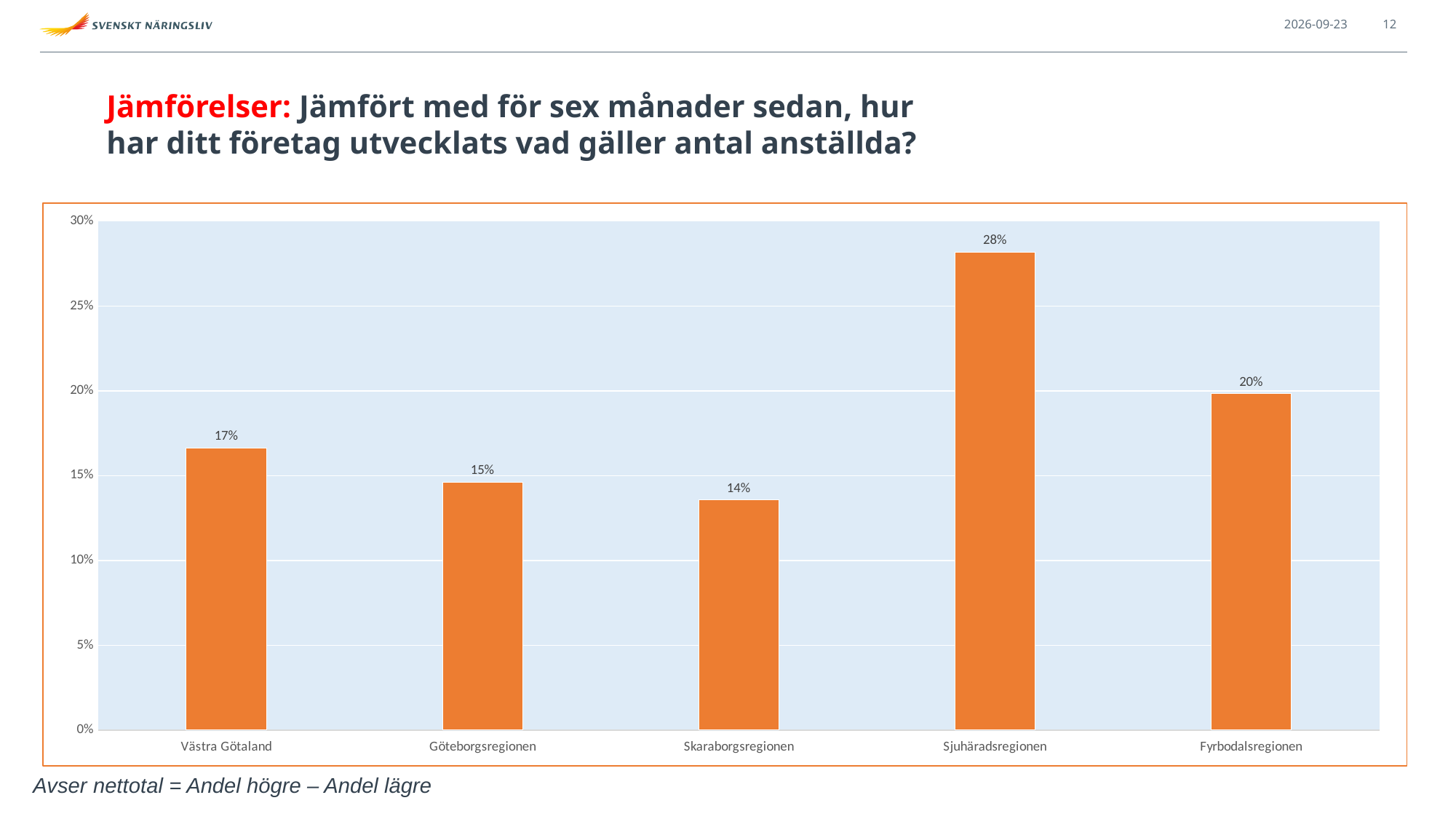
Which region has the highest value? Sjuhäradsregionen What is the value for Sjuhäradsregionen? 28% How many regions are shown on the chart? 5 Which region has the lowest value? Skaraborgsregionen What is the value for Västra Götaland? 17% What is the difference between the values for Sjuhäradsregionen and Göteborgsregionen? 13 percentage points What is the value for Fyrbodalsregionen? 20% Which is larger, the value for Fyrbodalsregionen or the value for Västra Götaland? Fyrbodalsregionen What is the value for Skaraborgsregionen? 14% Is the value for Sjuhäradsregionen greater or less than 25%? greater What kind of chart is shown on the slide? Bar chart What colour are the bars in the chart? Orange